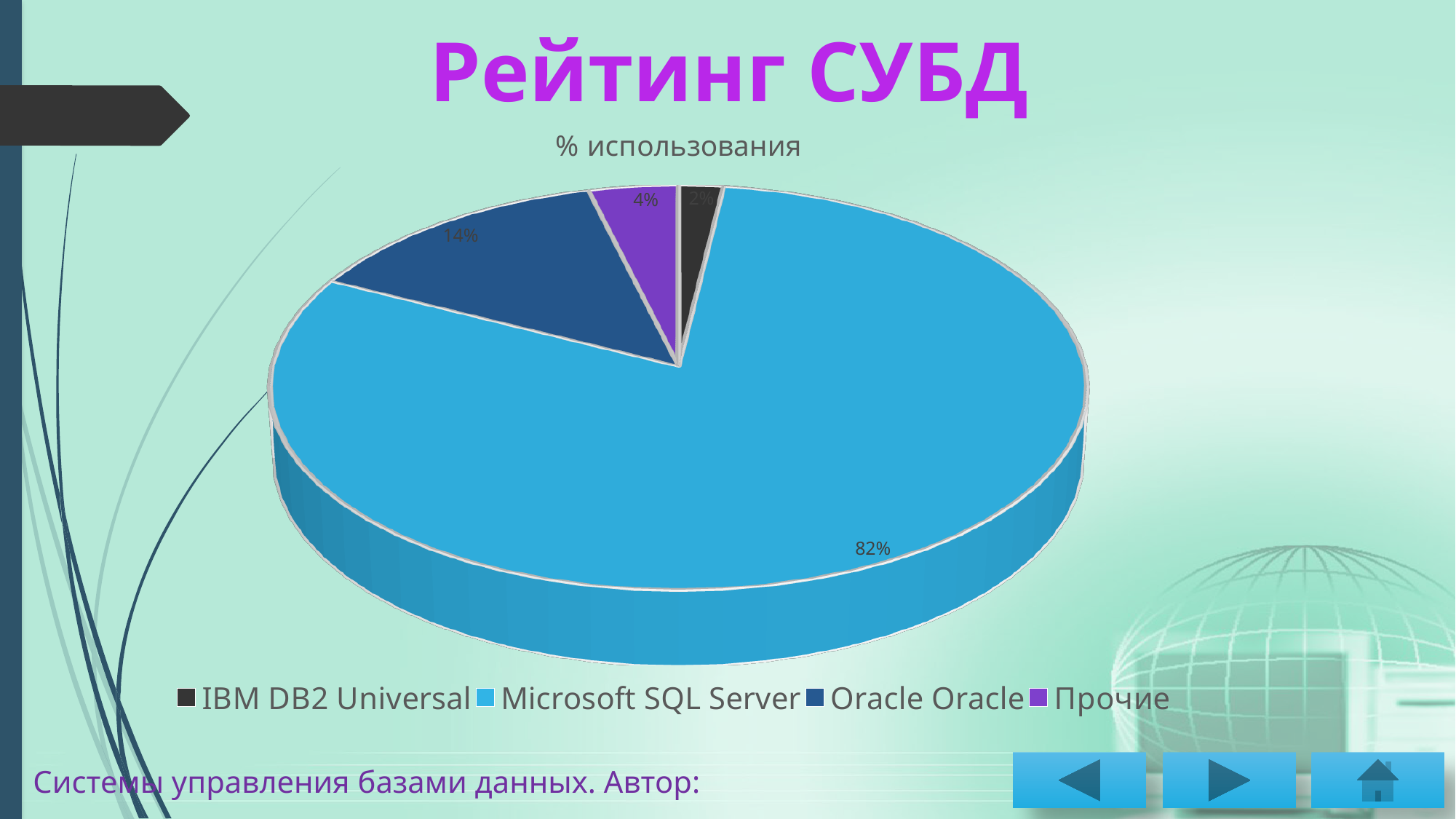
What colour is the slice for Прочие? purple Which category has the smallest share of the pie? IBM DB2 Universal What percentage is shown for Oracle Oracle? 14% What kind of chart is shown on the slide? pie chart Which is larger, the share for Oracle Oracle or the share for Прочие? Oracle Oracle Which category has the largest share of the pie? Microsoft SQL Server What percentage is shown for IBM DB2 Universal? 2% What percentage is shown for Microsoft SQL Server? 82% What is the difference between the shares of Microsoft SQL Server and Oracle Oracle? 68% What percentage is shown for Прочие? 4% What is the title of the chart? % использования How many categories does the legend list? 4